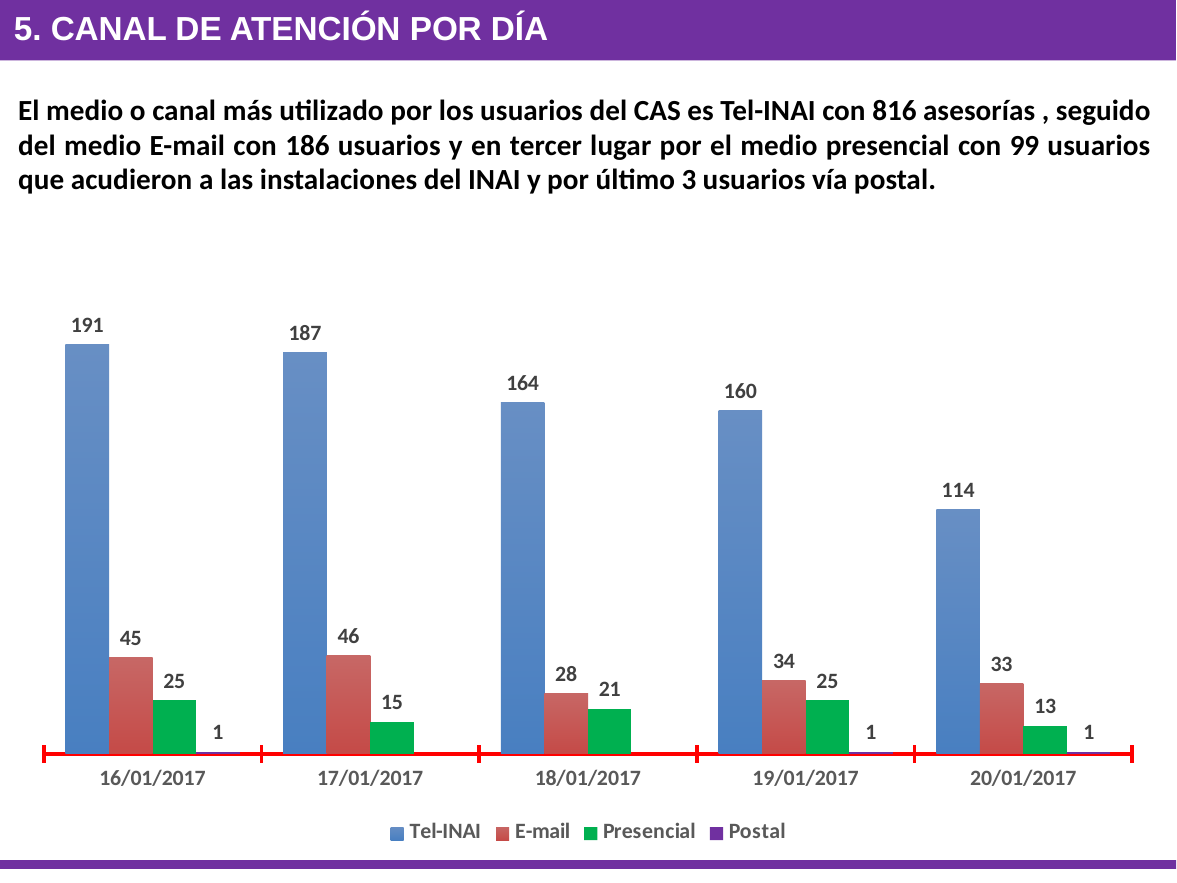
What kind of chart is shown on the slide? bar chart How many dates are shown on the x axis? 5 What is the Presencial value for 18/01/2017? 21 On which date is the Tel-INAI value highest? 16/01/2017 What is the E-mail value for 17/01/2017? 46 On which date is the Tel-INAI value lowest? 20/01/2017 Which is larger, the E-mail value for 19/01/2017 or the E-mail value for 20/01/2017? 19/01/2017 How many series does the legend list? 4 What is the difference between the Tel-INAI values for 16/01/2017 and 20/01/2017? 77 What is the Tel-INAI value for 16/01/2017? 191 What is the Postal value for 19/01/2017? 1 Does the Tel-INAI series rise or fall from 16/01/2017 to 20/01/2017? fall